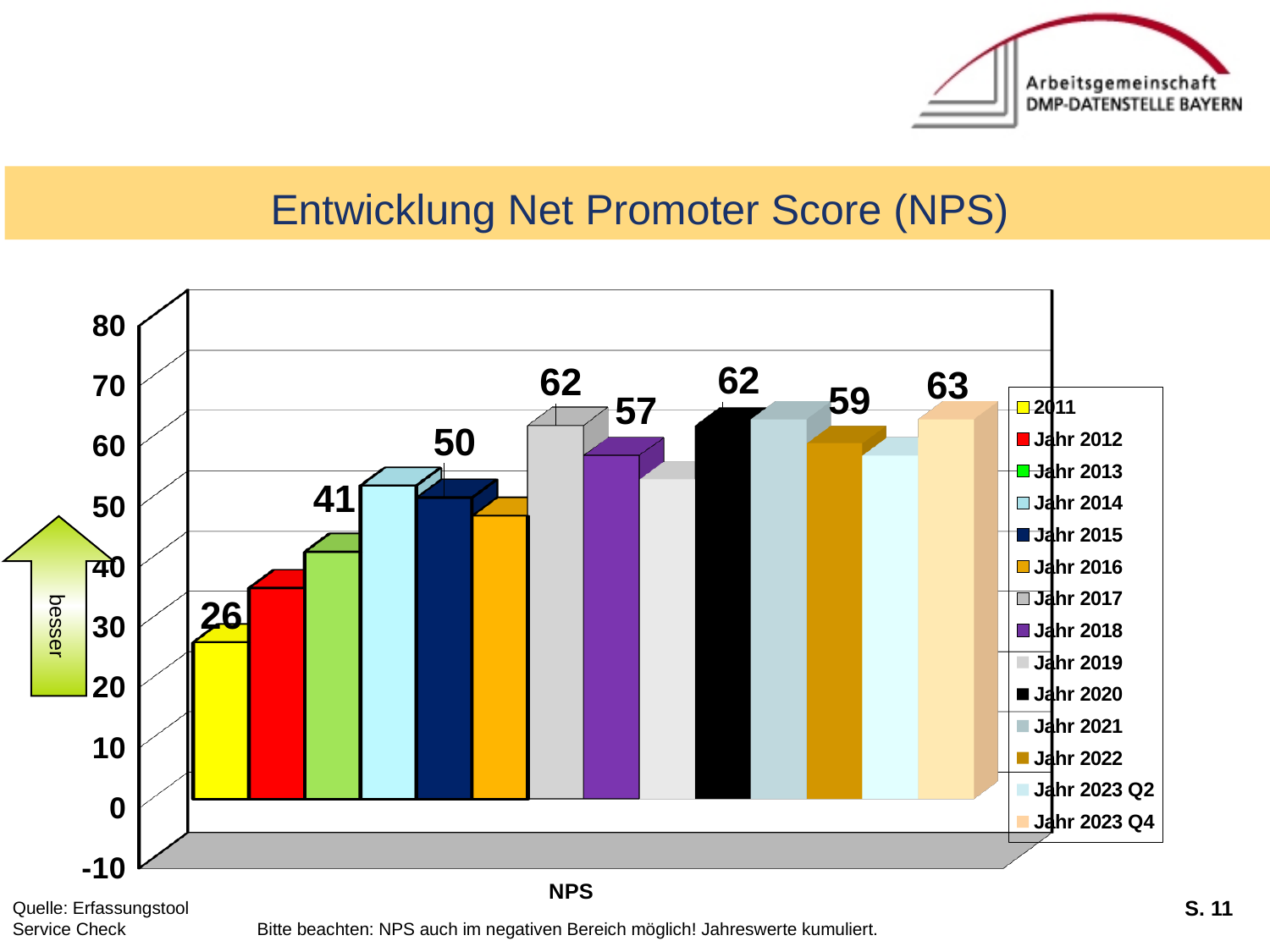
What is the NPS value for Jahr 2022? 59 What is the NPS value for 2011? 26 Which is larger, the NPS for Jahr 2013 or for Jahr 2018? Jahr 2018 Which year has the lowest NPS value? 2011 What kind of chart is shown on the slide? bar chart Is the NPS value for Jahr 2012 greater or less than 40? less What is the difference between the NPS for Jahr 2023 Q4 and the NPS for 2011? 37 What is the NPS value for Jahr 2023 Q4? 63 How many series does the legend list? 14 What is the NPS value for Jahr 2018? 57 What is the NPS value for Jahr 2013? 41